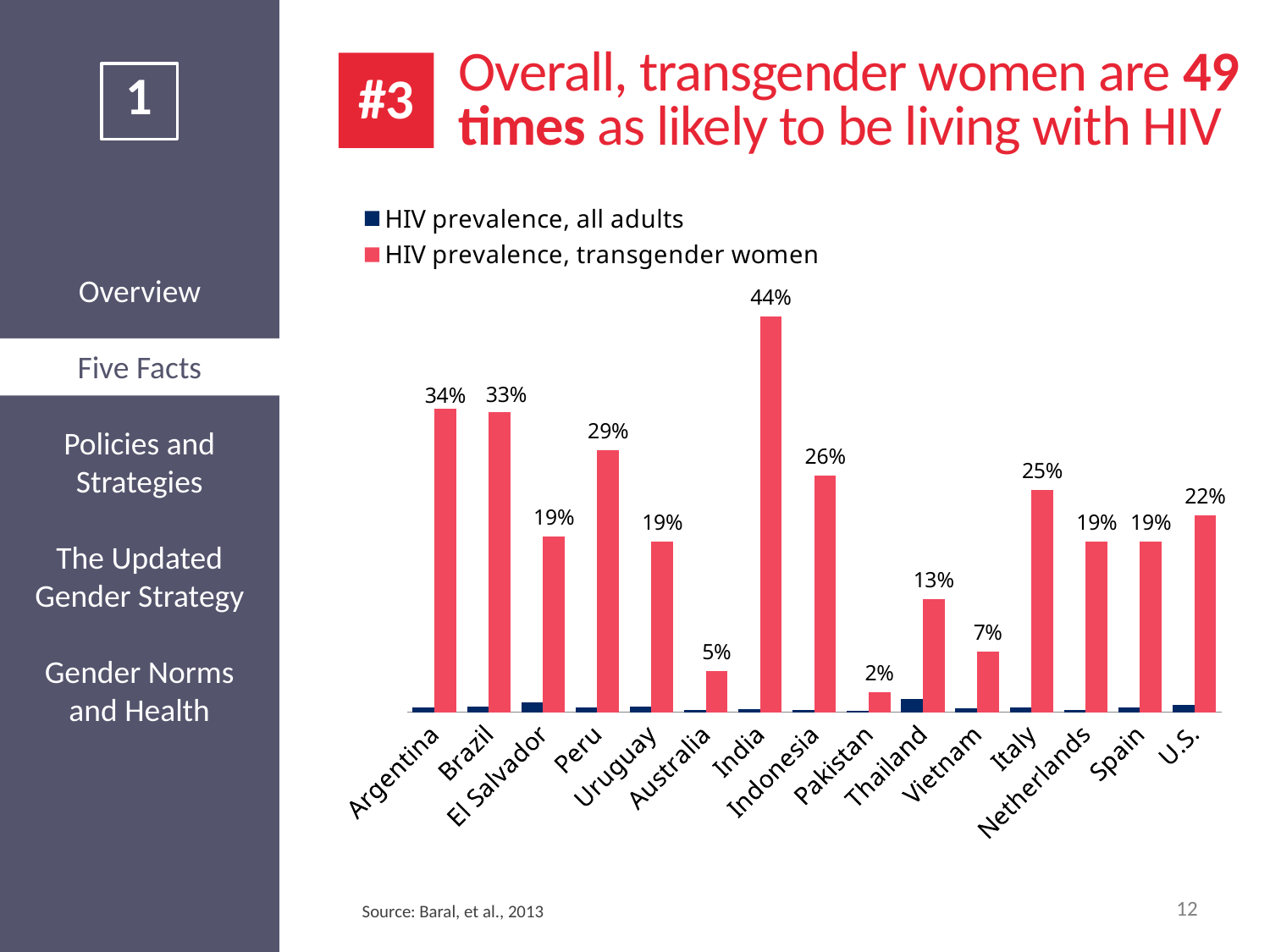
Which has a higher HIV prevalence among transgender women, Peru or Italy? Peru How many series does the legend list? 2 What is the HIV prevalence among transgender women in India? 44% Which series is shown in red in the chart? HIV prevalence, transgender women What is the HIV prevalence among transgender women in Argentina? 34% Which country has the lowest HIV prevalence among transgender women? Pakistan What is the difference between the HIV prevalence among transgender women in India and in Indonesia? 18% What kind of chart is shown on the slide? Bar chart What is the HIV prevalence among transgender women in Pakistan? 2% Which country has the highest HIV prevalence among transgender women? India What is the HIV prevalence among transgender women in Thailand? 13% How many countries are shown on the x axis of the chart? 15